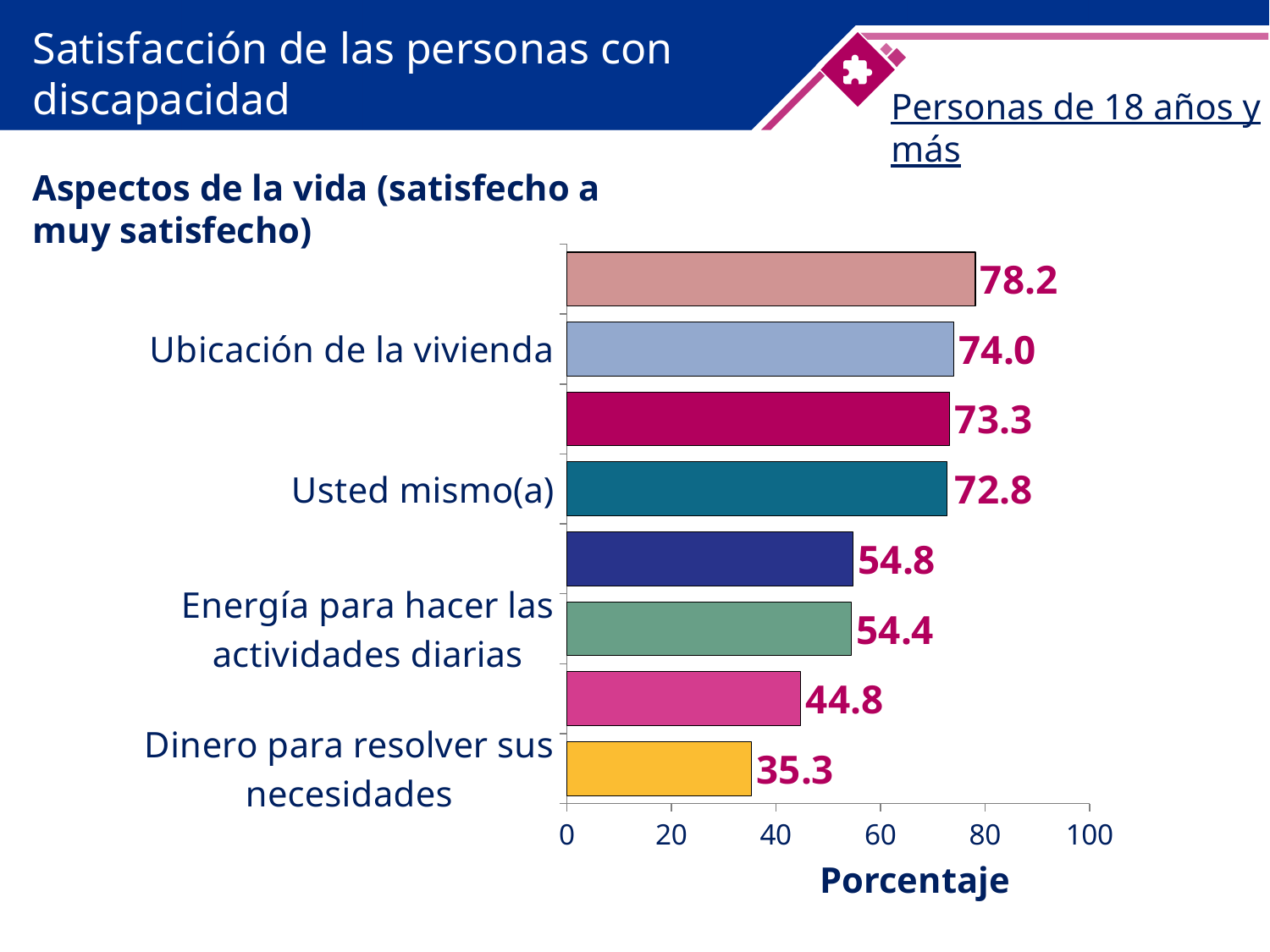
Which is larger, the value for "Usted mismo(a)" or the value for "Energía para hacer las actividades diarias"? Usted mismo(a) What is the value of the topmost bar in the chart? 78.2 What is the value for "Usted mismo(a)"? 72.8 What is the value for "Energía para hacer las actividades diarias"? 54.4 What kind of chart is shown on the slide? bar chart What is the value for "Ubicación de la vivienda"? 74.0 What is the difference between the values for "Ubicación de la vivienda" and "Dinero para resolver sus necesidades"? 38.7 Which labelled category has the lowest value? Dinero para resolver sus necesidades What is the value for "Dinero para resolver sus necesidades"? 35.3 What is the highest value shown in the chart? 78.2 What is the label of the horizontal axis? Porcentaje How many bars are plotted in the chart? 8